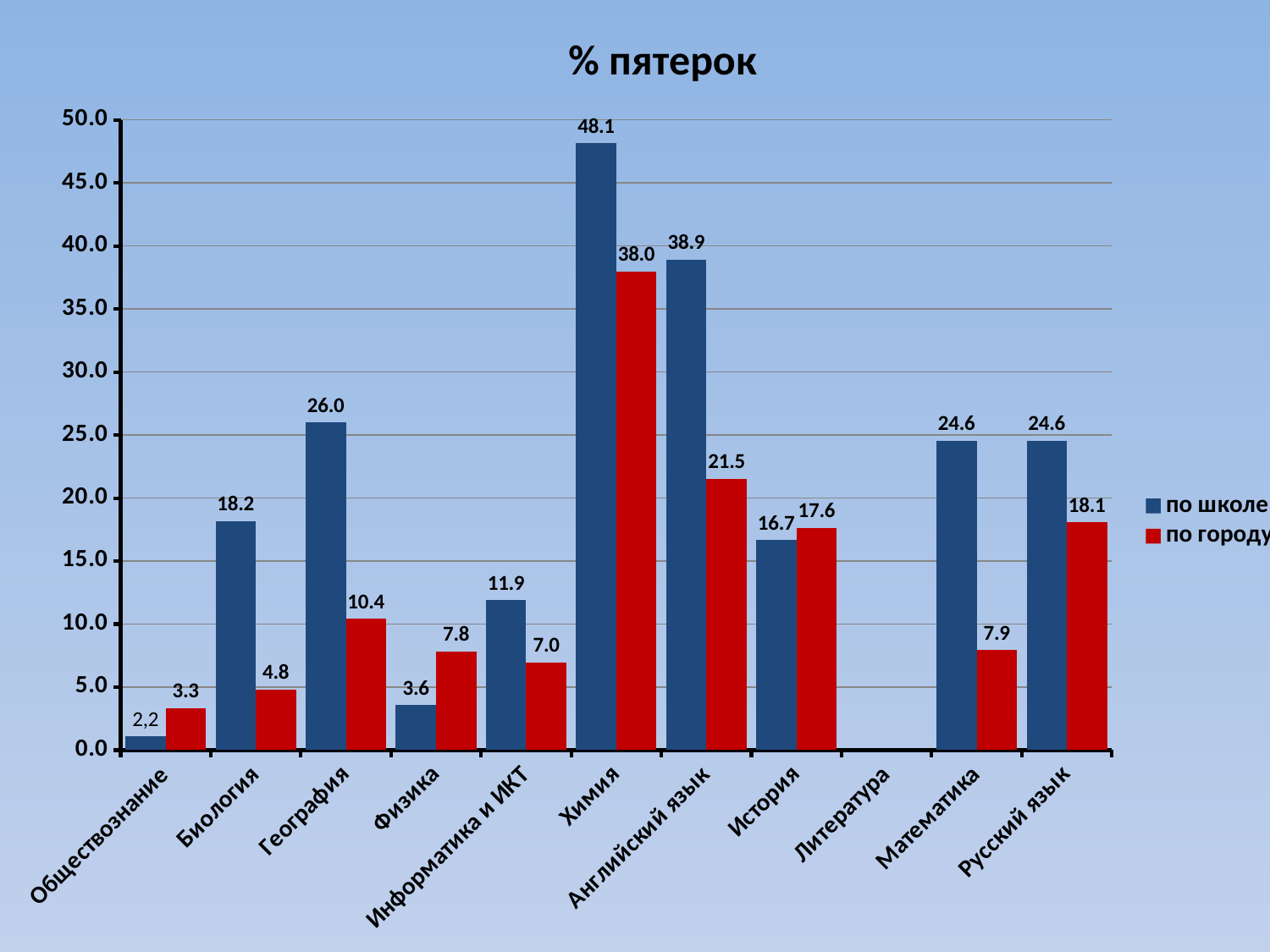
What is the value for Математика in the по городу series? 7.9 What is the difference between the по школе and по городу values for География? 15.6 What is the value for Английский язык in the по городу series? 21.5 Which category has the highest value in the по школе series? Химия Which is larger for Физика: the по школе value or the по городу value? по городу How many categories are shown on the x axis? 11 How many series does the legend list? 2 What is the value for Химия in the по школе series? 48.1 Is the по школе value for Биология greater or less than 15.0? greater Which category has the lowest value in the по городу series? Обществознание What is the title of the chart? % пятерок What kind of chart is shown on the slide? bar chart